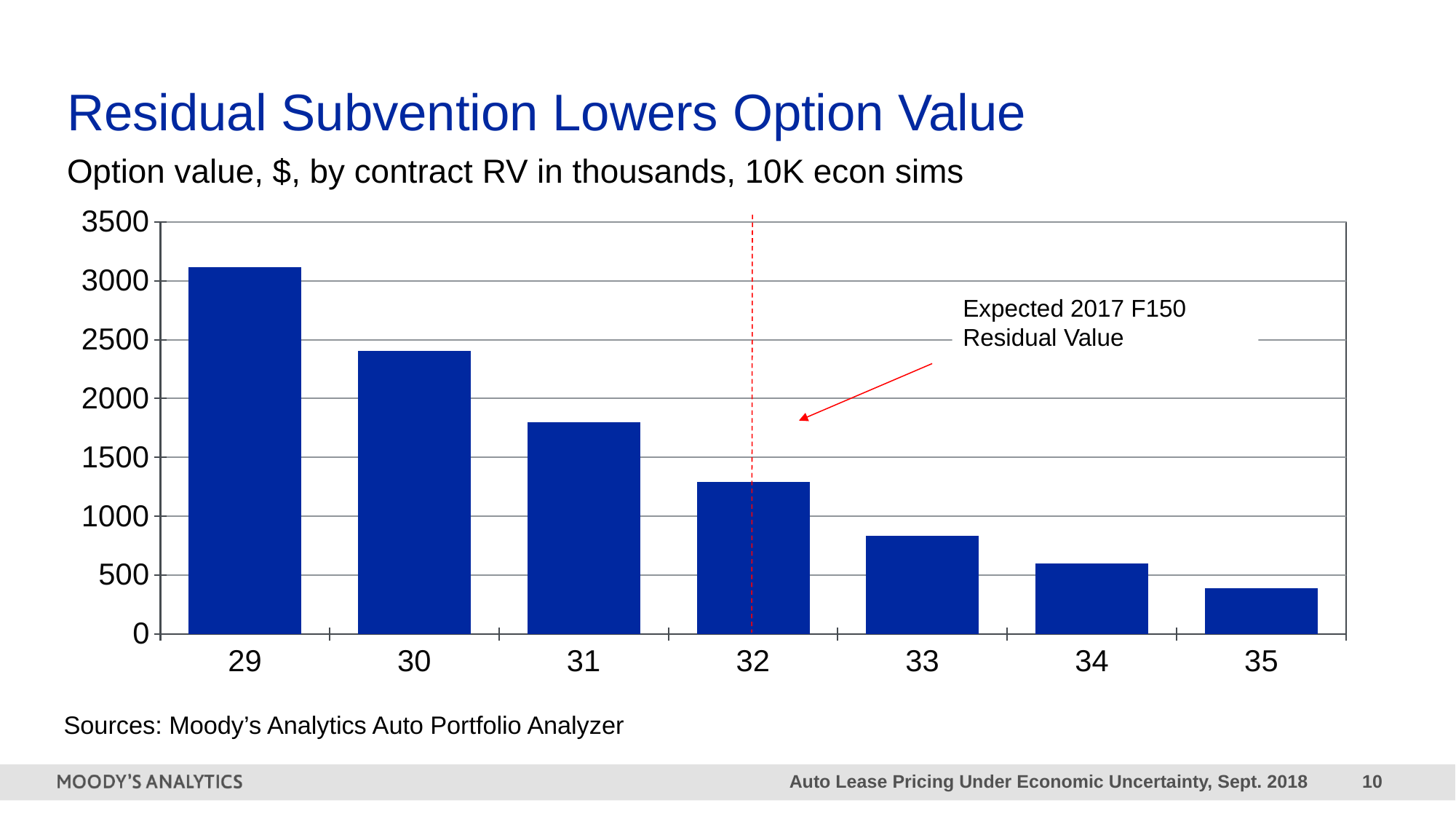
Do option values rise or fall as contract RV increases from 29 to 35? fall Which contract RV has the lowest option value? 35 Is the option value for contract RV 30 greater or less than 2000? greater Is the option value for contract RV 33 greater or less than 1000? less Which contract RV has the highest option value? 29 Is the option value for contract RV 31 greater or less than 2000? less Which has a larger option value, contract RV 30 or contract RV 33? 30 Which contract RV does the dashed red line labelled 'Expected 2017 F150 Residual Value' pass through? 32 What kind of chart is shown on the slide? bar chart How many contract RV categories are shown on the x axis? 7